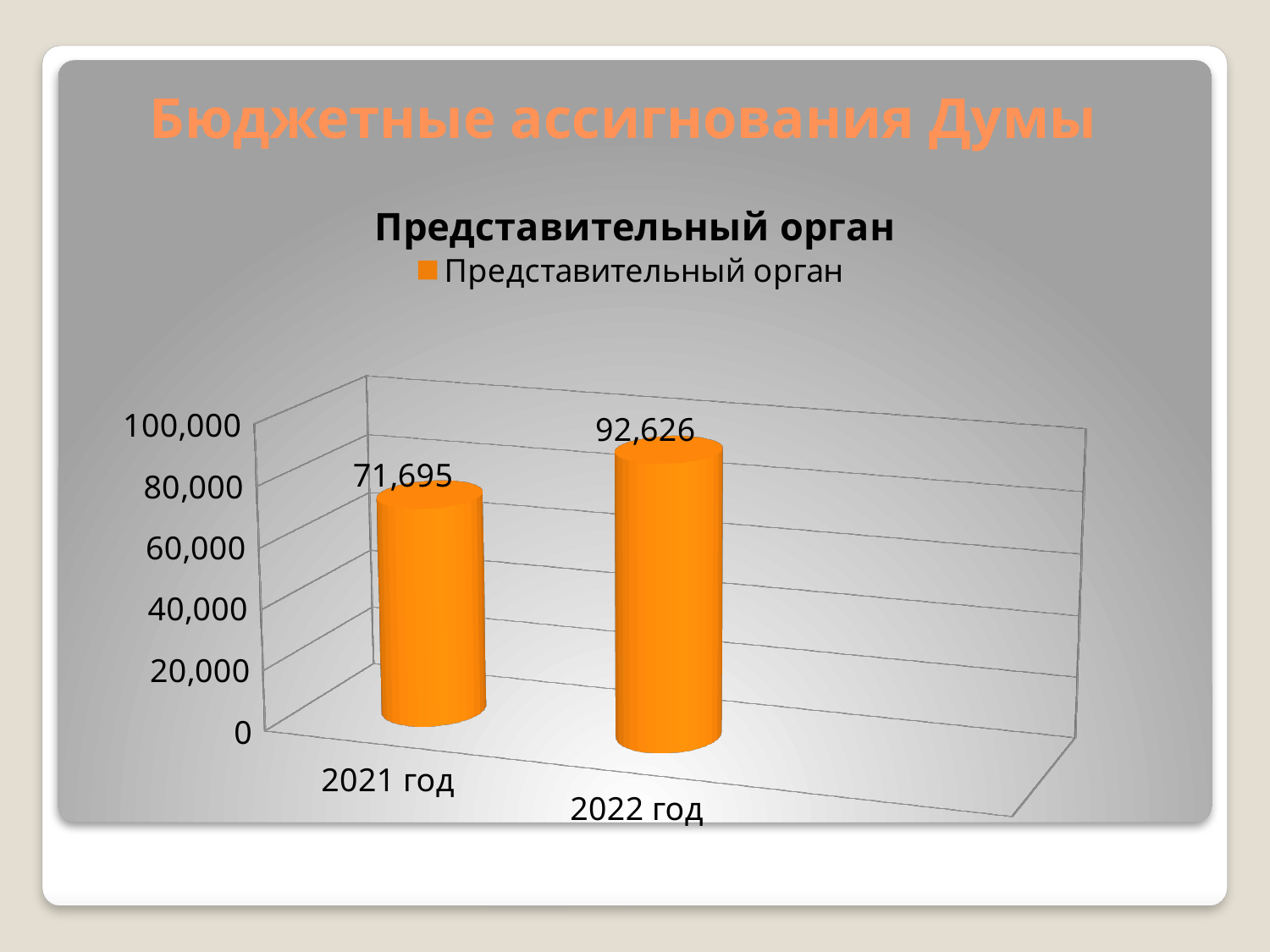
Is the value for 2022 год greater or less than 80,000? greater How many categories are shown on the x axis? 2 Is the value for 2021 год greater or less than 60,000? greater Which year has the lower value? 2021 год Is the value for 2021 год larger or smaller than the value for 2022 год? smaller What is the difference between the values for 2022 год and 2021 год? 20,931 What is the value for 2022 год? 92,626 What kind of chart is shown? bar chart How many series does the legend list? 1 What is the value for 2021 год? 71,695 Which year has the higher value? 2022 год Do the values rise or fall from 2021 год to 2022 год? rise